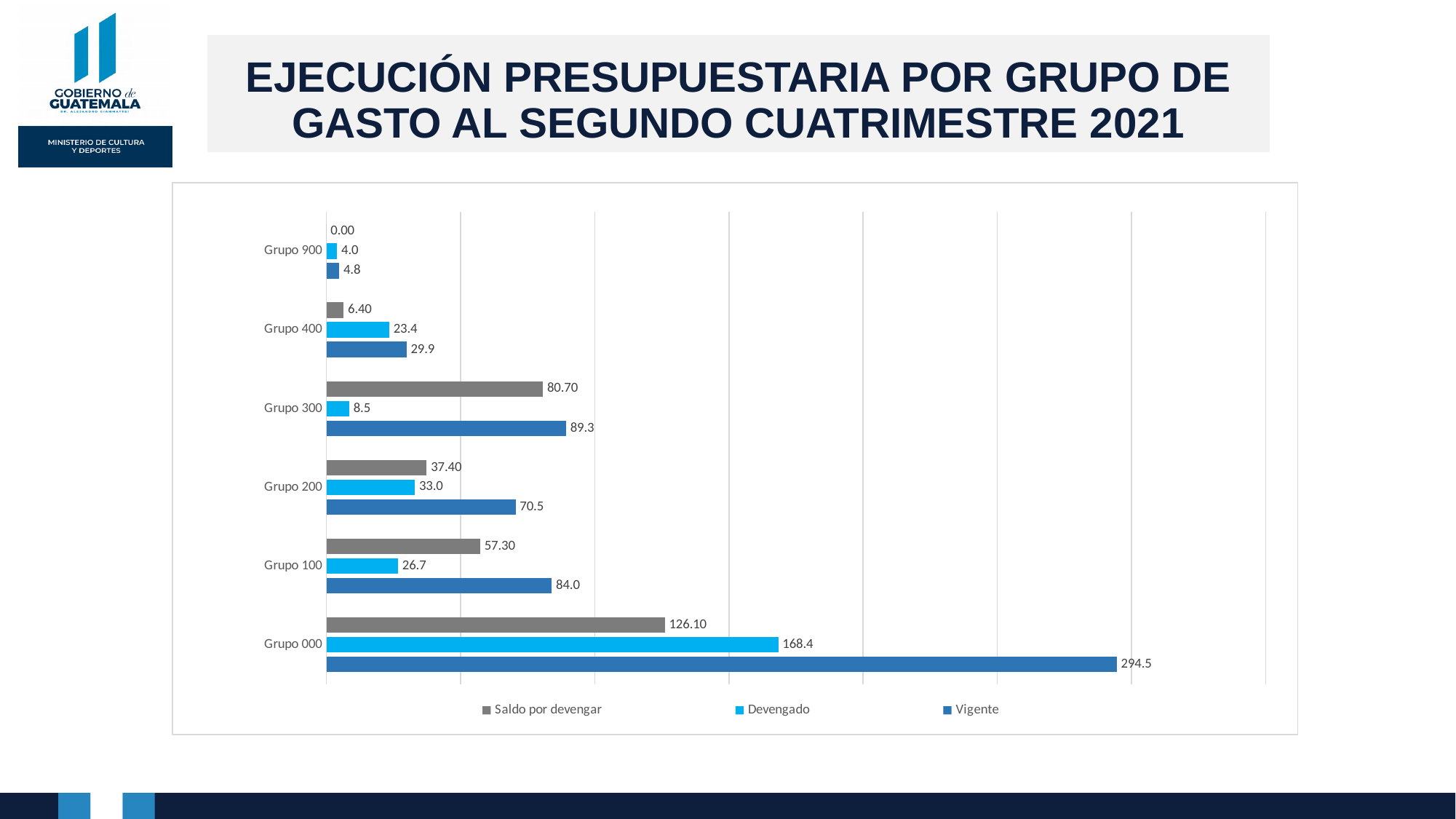
What kind of chart is shown on the slide? Bar chart What is the Vigente value for Grupo 000? 294.5 What is the difference between the Vigente and Devengado values for Grupo 100? 57.3 Which is larger for Grupo 300: the Saldo por devengar value or the Devengado value? Saldo por devengar How many groups (categories) are shown on the chart? 6 What is the Saldo por devengar value for Grupo 300? 80.70 Which series is shown in gray in the legend? Saldo por devengar Which group has the lowest Devengado value? Grupo 900 Which group has the highest Vigente value? Grupo 000 What is the Devengado value for Grupo 900? 4.0 How many series does the legend list? 3 What is the Devengado value for Grupo 200? 33.0